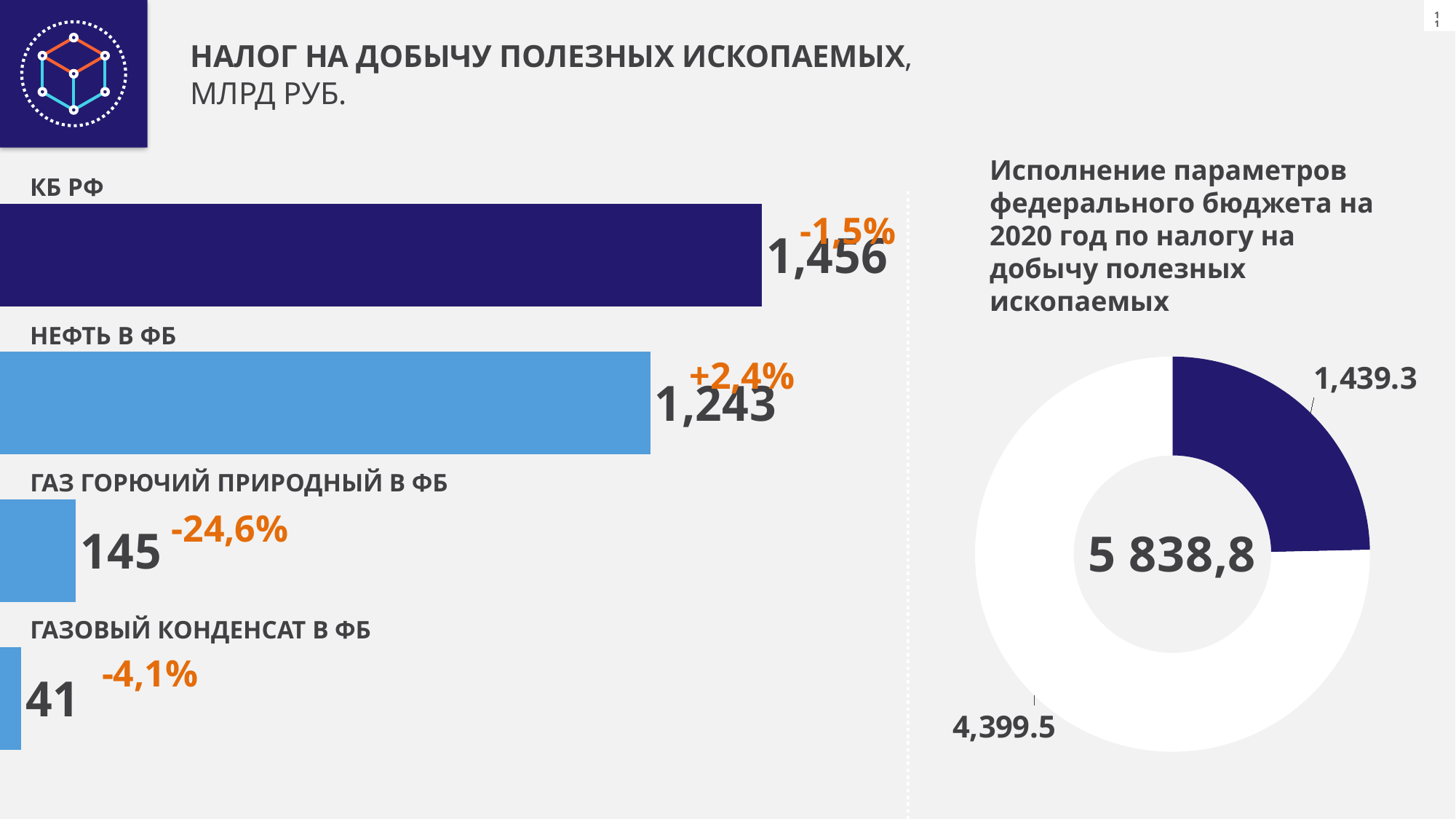
In the bar chart on the left, what is the value for ГАЗ ГОРЮЧИЙ ПРИРОДНЫЙ В ФБ? 145 In the bar chart on the left, what is the difference between the values for КБ РФ and НЕФТЬ В ФБ? 213 How many categories does the bar chart on the left show? 4 What kind of chart is shown on the right side of the slide? Donut chart In the donut chart on the right, what total value is shown in the centre? 5 838,8 In the bar chart on the left, what is the value for КБ РФ? 1,456 In the bar chart on the left, what is the value for НЕФТЬ В ФБ? 1,243 In the bar chart on the left, which category has the lowest value? ГАЗОВЫЙ КОНДЕНСАТ В ФБ In the donut chart on the right, what is the value of the dark blue segment? 1,439.3 In the bar chart on the left, which is larger: the value for ГАЗ ГОРЮЧИЙ ПРИРОДНЫЙ В ФБ or ГАЗОВЫЙ КОНДЕНСАТ В ФБ? ГАЗ ГОРЮЧИЙ ПРИРОДНЫЙ В ФБ In the bar chart on the left, which category has the highest value? КБ РФ In the bar chart on the left, what percentage change is shown next to ГАЗОВЫЙ КОНДЕНСАТ В ФБ? -4,1%